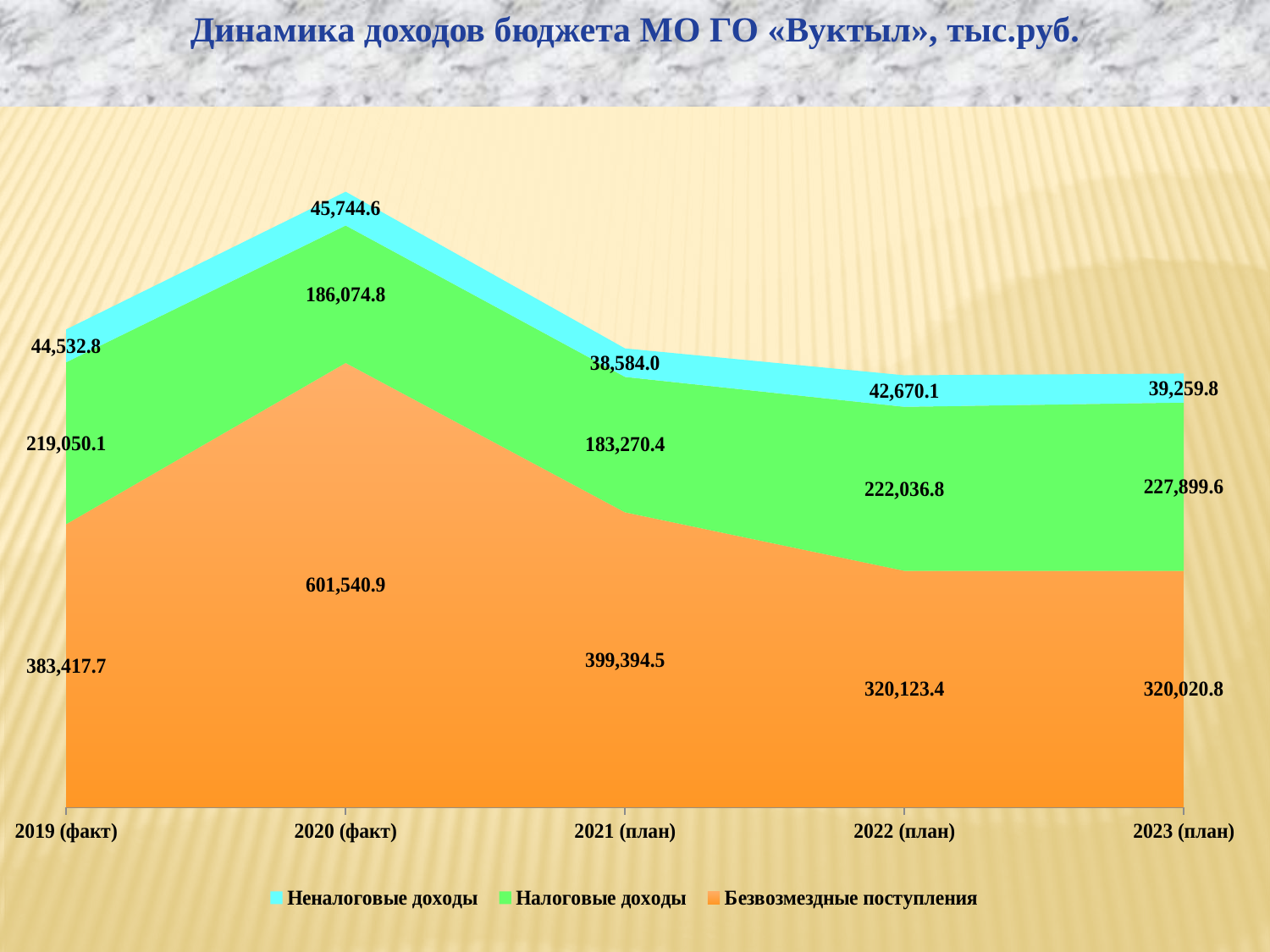
What is the difference between Безвозмездные поступления in 2020 (факт) and 2019 (факт)? 218,123.2 Which is larger: Налоговые доходы in 2022 (план) or in 2021 (план)? 2022 (план) Which series is shown in orange in the legend? Безвозмездные поступления What type of chart is shown on the slide? Stacked area chart In which period is Неналоговые доходы lowest? 2021 (план) How many time periods are shown on the x axis? 5 What is the value of Безвозмездные поступления for 2020 (факт)? 601,540.9 What is the value of Неналоговые доходы for 2021 (план)? 38,584.0 In which period is Безвозмездные поступления highest? 2020 (факт) What is the value of Налоговые доходы for 2023 (план)? 227,899.6 How many series does the legend list? 3 What is the total of all three series for 2023 (план)? 587,180.2